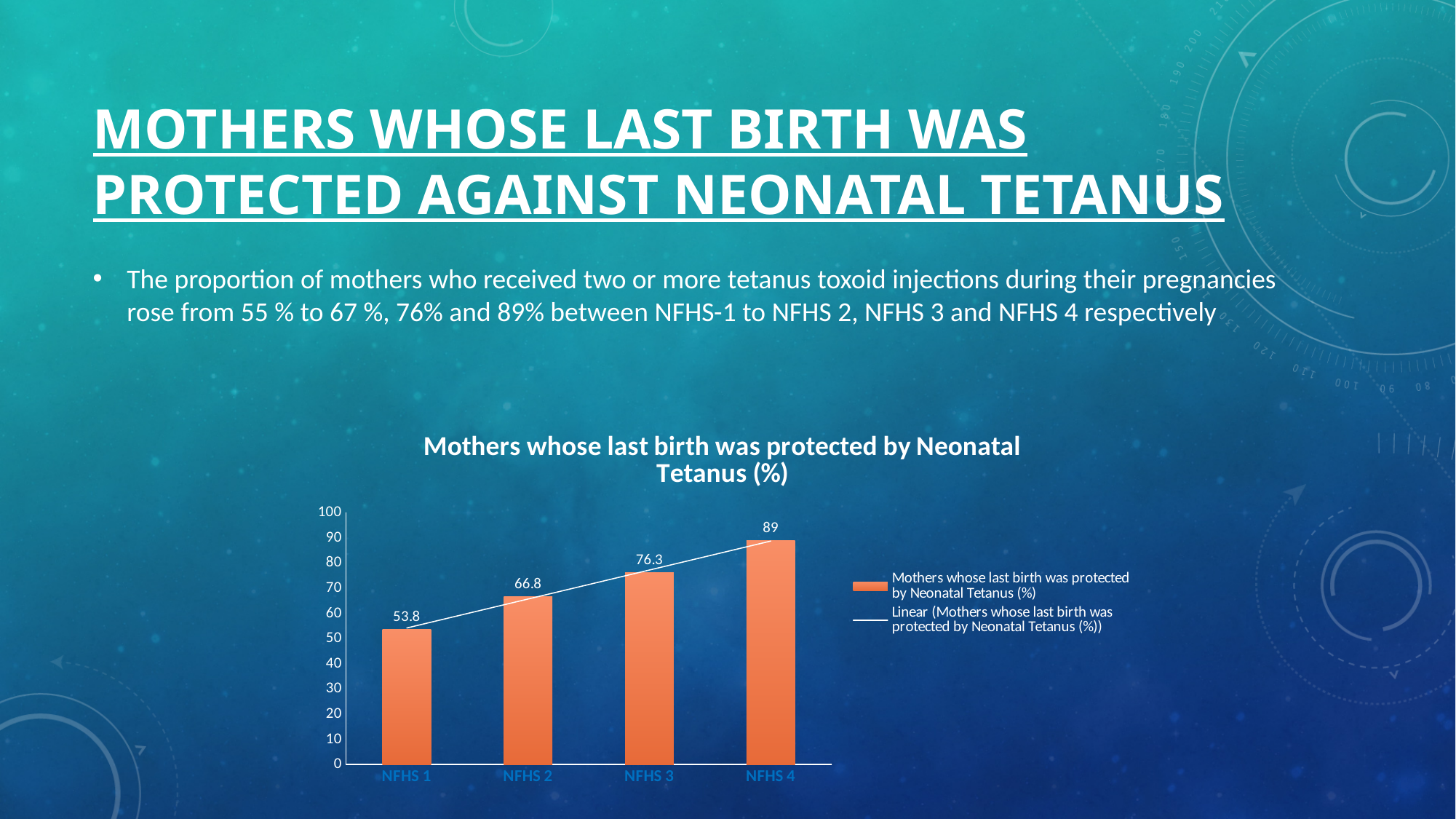
Which category has the lowest value? NFHS 1 How many categories are shown on the x axis? 4 Which is larger, the value for NFHS 2 or NFHS 3? NFHS 3 What is the difference between the values for NFHS 2 and NFHS 1? 13 What is the difference between the values for NFHS 4 and NFHS 1? 35.2 What is the value for NFHS 1? 53.8 Do the values rise or fall from NFHS 1 to NFHS 4? rise Is the value for NFHS 2 greater or less than 60? greater Which category has the highest value? NFHS 4 What is the value for NFHS 3? 76.3 What kind of chart is shown on the slide? bar chart What is the value for NFHS 4? 89